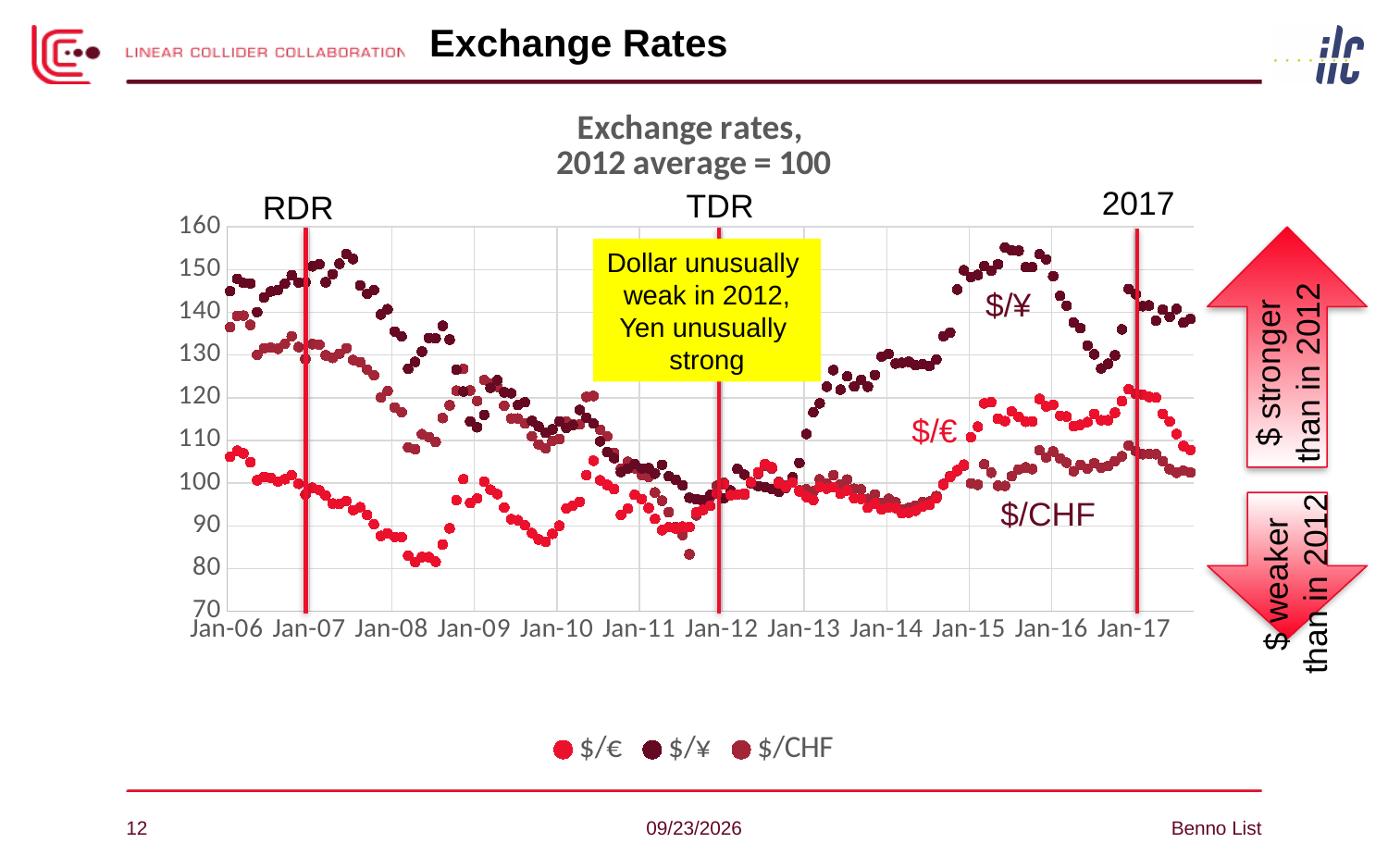
Is the value of the $/¥ series around Jan-15 greater or less than 140? greater Around Jan-07, which of the three series has the highest value? $/¥ How many series does the legend list? 3 Is the value of the $/CHF series around Jan-07 greater or less than 120? greater Around Jan-15, which series is higher: $/¥ or $/€? $/¥ How many year labels are shown on the x axis? 12 Around Jan-14, which of the three series has the lowest value? $/€ What kind of chart is shown on the slide? scatter chart Does the $/¥ series rise or fall between Jan-07 and Jan-12? fall What is the title of the chart? Exchange rates, 2012 average = 100 Is the value of the $/€ series around Jan-08 greater or less than 100? less Which three series are listed in the chart legend? $/€, $/¥, $/CHF